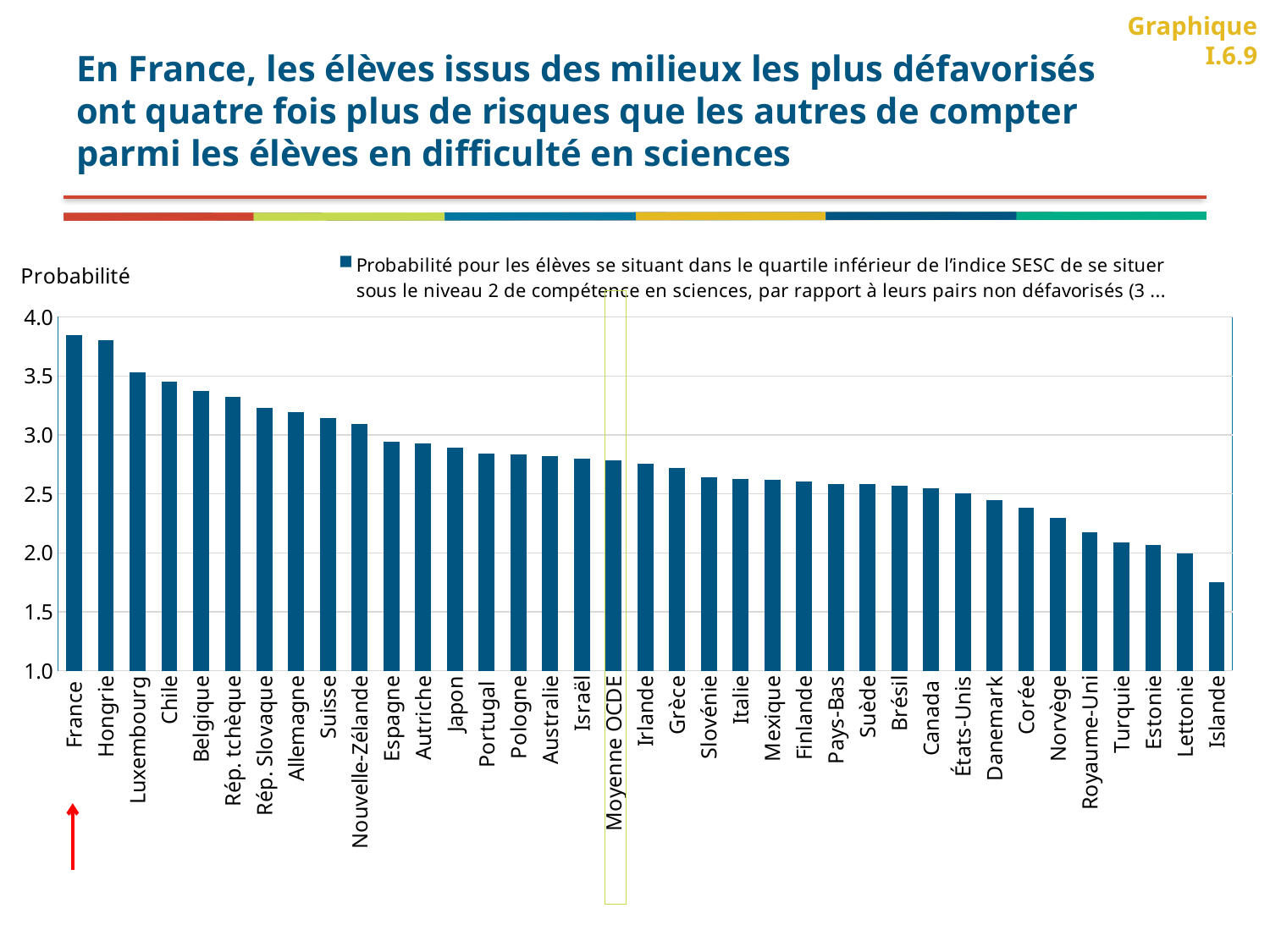
Is the value for Moyenne OCDE greater or less than 2.5? greater Which country has the lowest probability value in the chart? Islande Which has the larger value, Hongrie or Chile? Hongrie Is the value for Suisse greater or less than 3.0? greater Is the value for Corée greater or less than 2.5? less Which country has the highest probability value in the chart? France Do the values rise or fall from left to right along the x axis? fall What label is shown on the vertical axis of the chart? Probabilité What kind of chart is shown on the slide? bar chart How many series does the legend list? 1